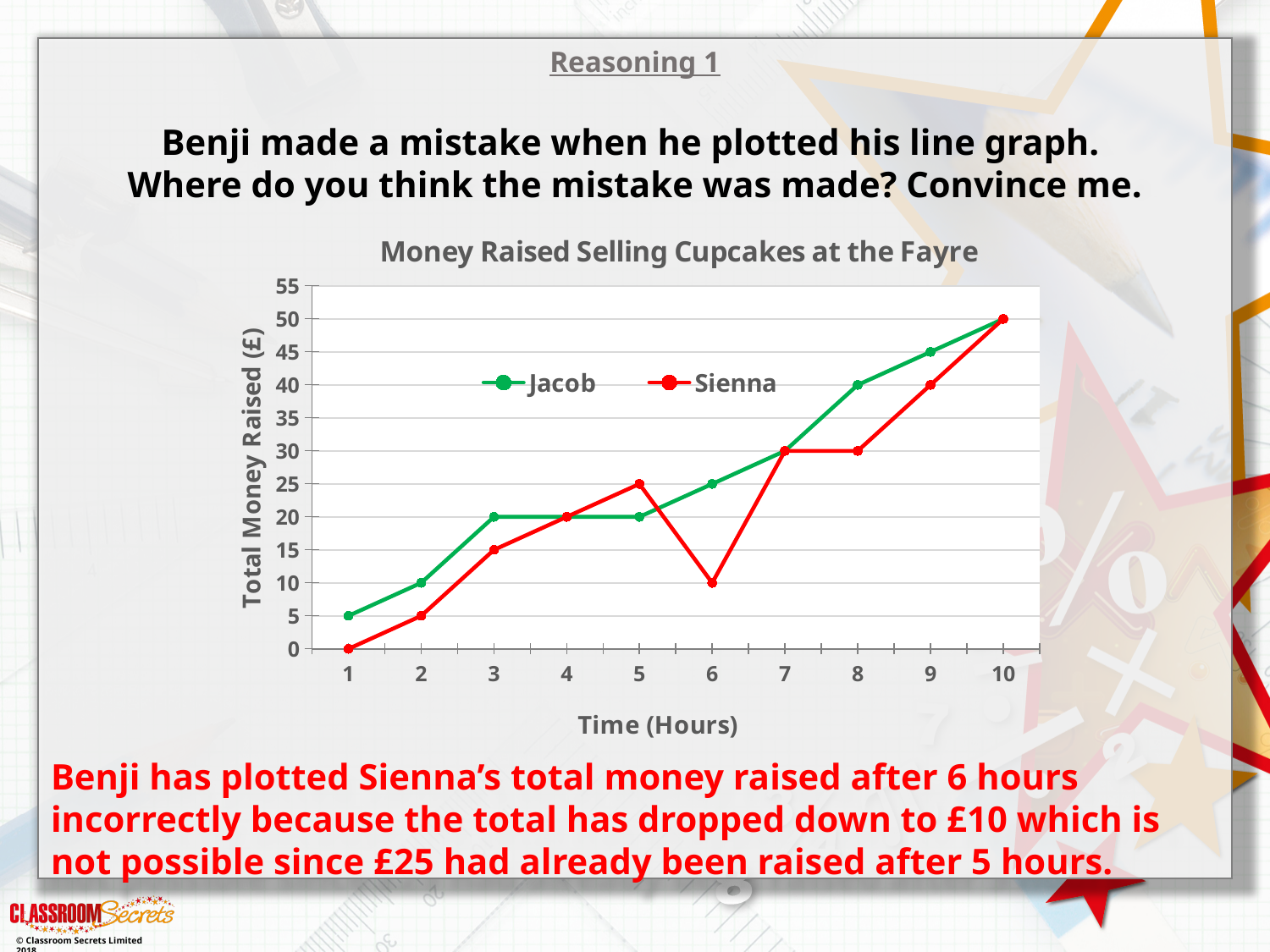
What is the title of the chart? Money Raised Selling Cupcakes at the Fayre How many series does the legend list? 2 At which hour is Jacob's total money raised lowest? 1 What kind of chart is shown on the slide? line chart After 9 hours, who has raised more money, Jacob or Sienna? Jacob What is the total money raised by Sienna after 6 hours? £10 Does Jacob's total money raised generally rise or fall over time? rise What is the total money raised by Jacob after 8 hours? £40 What is the label of the y axis? Total Money Raised (£) How many time points are plotted along the x axis? 10 What is the total money raised by Sienna after 5 hours? £25 What is the difference between Jacob's and Sienna's totals after 6 hours? £15